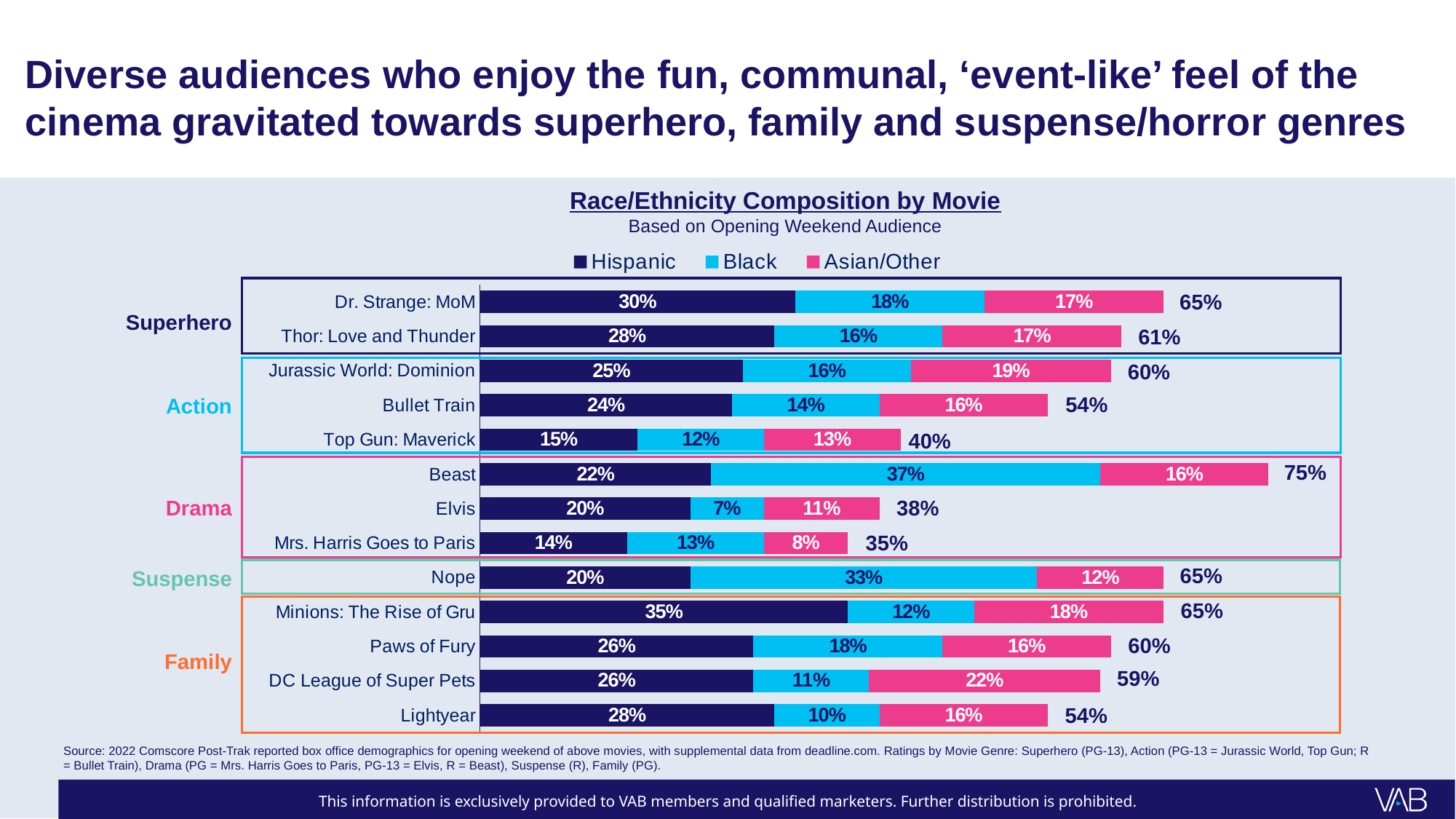
Which movie has the lowest total diverse audience share shown at the end of its bar? Mrs. Harris Goes to Paris What is the Black share of the opening weekend audience for Beast? 37% What is the Asian/Other share of the opening weekend audience for DC League of Super Pets? 22% Which genre group contains the most movies in the chart? Family What is the difference between the Hispanic share for Minions: The Rise of Gru and the Hispanic share for Top Gun: Maverick? 20% Which movie has the highest total diverse audience share shown at the end of its bar? Beast What is the total diverse audience share for Nope? 65% What is the Hispanic share of the opening weekend audience for Dr. Strange: MoM? 30% What kind of chart is shown on the slide? Stacked bar chart Which movie has a larger Black audience share, Nope or Elvis? Nope How many movies are shown in the chart? 13 How many series does the legend list? 3